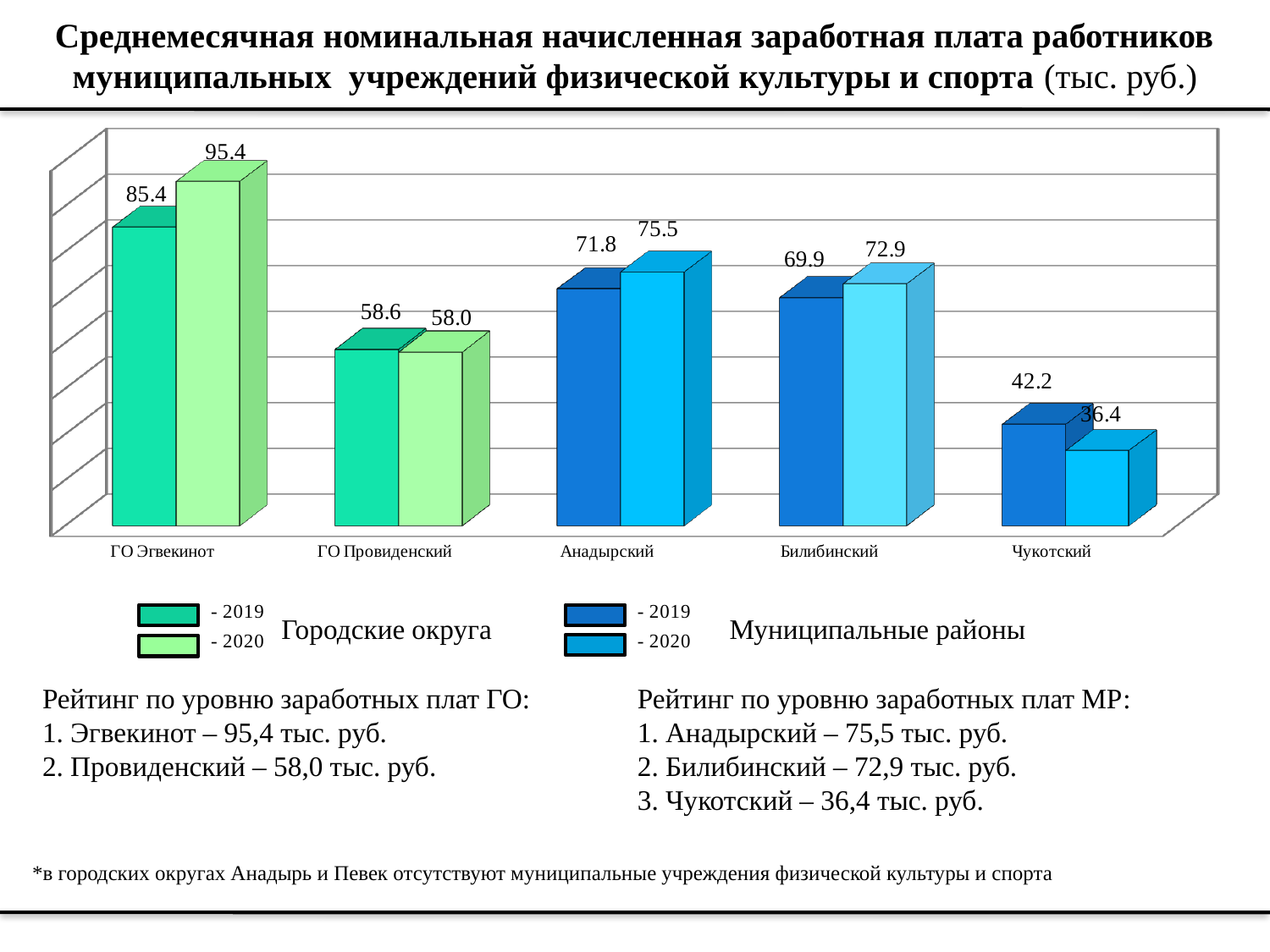
How many categories are shown on the x axis? 5 What is the 2020 value for ГО Эгвекинот? 95.4 Which two years does the legend list? 2019 and 2020 What kind of chart is shown on the slide? Bar chart Which category has the highest 2020 value? ГО Эгвекинот Which is larger for ГО Провиденский, the 2019 value or the 2020 value? 2019 What is the difference between the 2019 and 2020 values for Чукотский? 5.8 What is the difference between the 2020 and 2019 values for ГО Эгвекинот? 10.0 What is the 2019 value for Чукотский? 42.2 What is the 2019 value for Анадырский? 71.8 Which category has the lowest 2019 value? Чукотский What is the 2020 value for Билибинский? 72.9